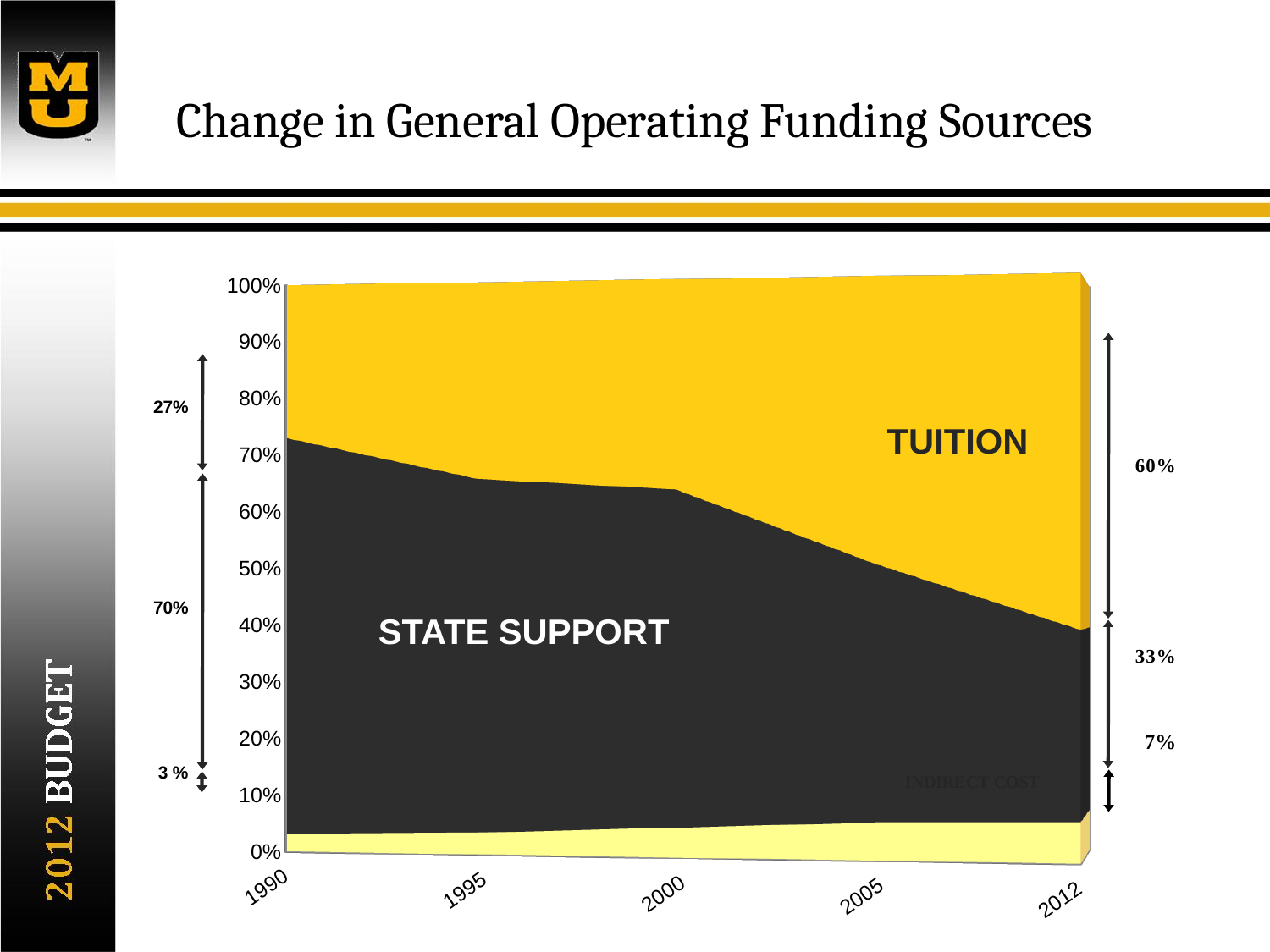
What share of general operating funding came from state support in 1990? 70% What share of general operating funding came from state support in 2012? 33% How many years are labelled on the x axis? 5 What is the title of the chart? Change in General Operating Funding Sources What share of general operating funding came from tuition in 1990? 27% Does the state support share rise or fall from 1990 to 2012? Fall What kind of chart is shown on the slide? Stacked area chart What share of general operating funding came from indirect cost in 2012? 7% By how many percentage points did the tuition share change between 1990 and 2012? 33 percentage points What share of general operating funding came from indirect cost in 1990? 3% What share of general operating funding came from tuition in 2012? 60% Which funding source had the largest share in 2012? Tuition